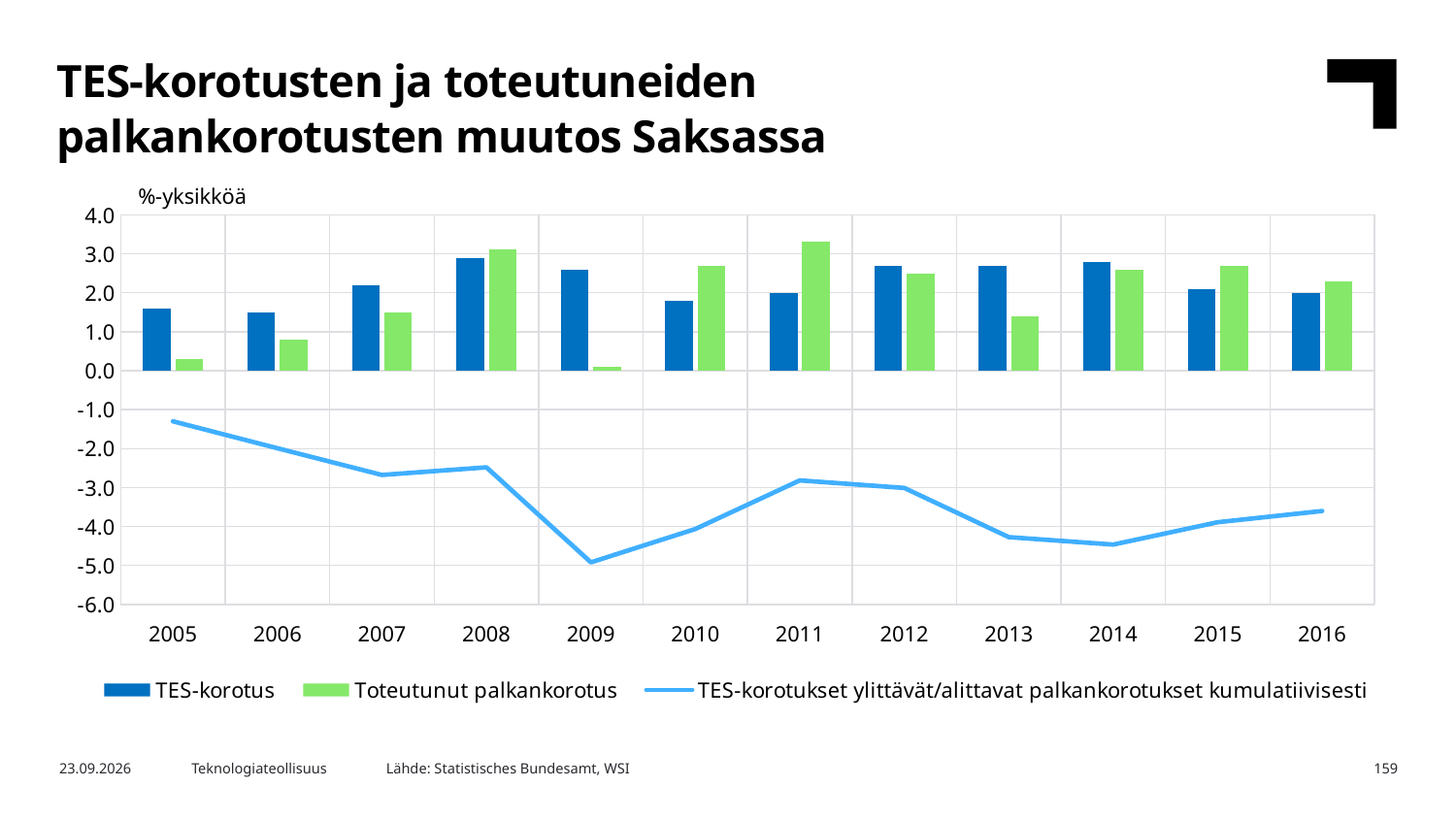
How many series does the legend list? 3 Is the Toteutunut palkankorotus value for 2005 greater or less than 1.0? less Is the value of the cumulative line in 2009 greater or less than -4.0? less Does the cumulative line rise or fall from 2005 to 2009? fall How many years are shown on the x axis? 12 In 2005, which is larger: TES-korotus or Toteutunut palkankorotus? TES-korotus In which year does the line TES-korotukset ylittävät/alittavat palkankorotukset kumulatiivisesti reach its lowest point? 2009 In which year is the Toteutunut palkankorotus bar lowest? 2009 What kind of chart is this? Combined bar and line chart What unit is shown above the y axis? %-yksikköä In 2011, which is larger: TES-korotus or Toteutunut palkankorotus? Toteutunut palkankorotus